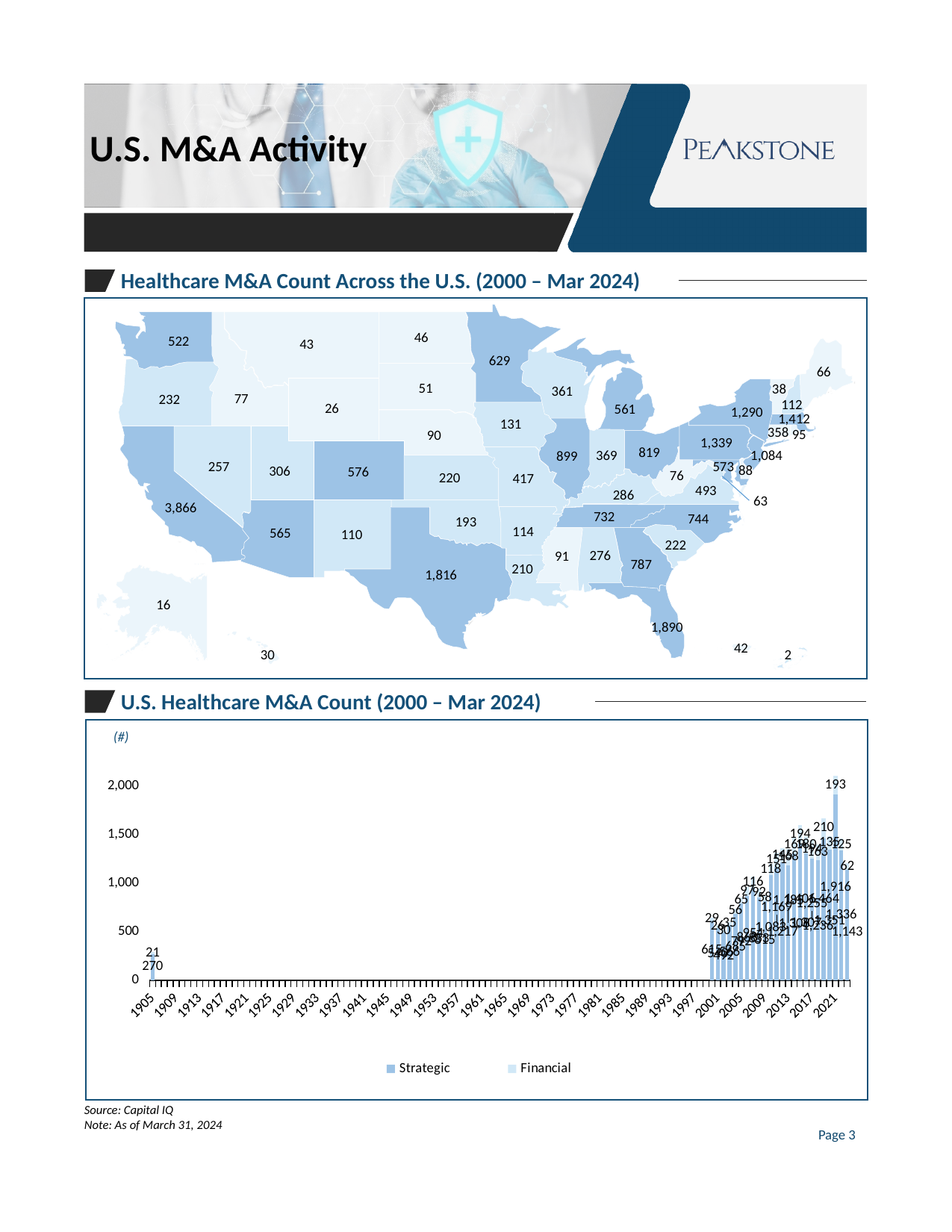
On the map chart 'Healthcare M&A Count Across the U.S. (2000 – Mar 2024)', what is the count shown for Florida? 1,890 In 'U.S. Healthcare M&A Count (2000 – Mar 2024)', is the total for 2021 greater or less than 1,500? greater On the map chart 'Healthcare M&A Count Across the U.S. (2000 – Mar 2024)', what is the count shown for Alaska? 16 On the map chart 'Healthcare M&A Count Across the U.S. (2000 – Mar 2024)', what is the lowest count shown? 2 In 'U.S. Healthcare M&A Count (2000 – Mar 2024)', do the bar totals generally rise or fall from 2000 to 2021? rise On the map chart 'Healthcare M&A Count Across the U.S. (2000 – Mar 2024)', what is the difference between the counts for California (3,866) and Texas (1,816)? 2,050 On the map chart 'Healthcare M&A Count Across the U.S. (2000 – Mar 2024)', what is the highest count shown for any state? 3,866 How many series does the legend of 'U.S. Healthcare M&A Count (2000 – Mar 2024)' list? 2 What kind of chart is 'U.S. Healthcare M&A Count (2000 – Mar 2024)'? Stacked bar chart On the map chart 'Healthcare M&A Count Across the U.S. (2000 – Mar 2024)', which has the larger count, Texas or Florida? Florida On the map chart 'Healthcare M&A Count Across the U.S. (2000 – Mar 2024)', what is the count shown for Texas? 1,816 What are the two series named in the legend of 'U.S. Healthcare M&A Count (2000 – Mar 2024)'? Strategic and Financial